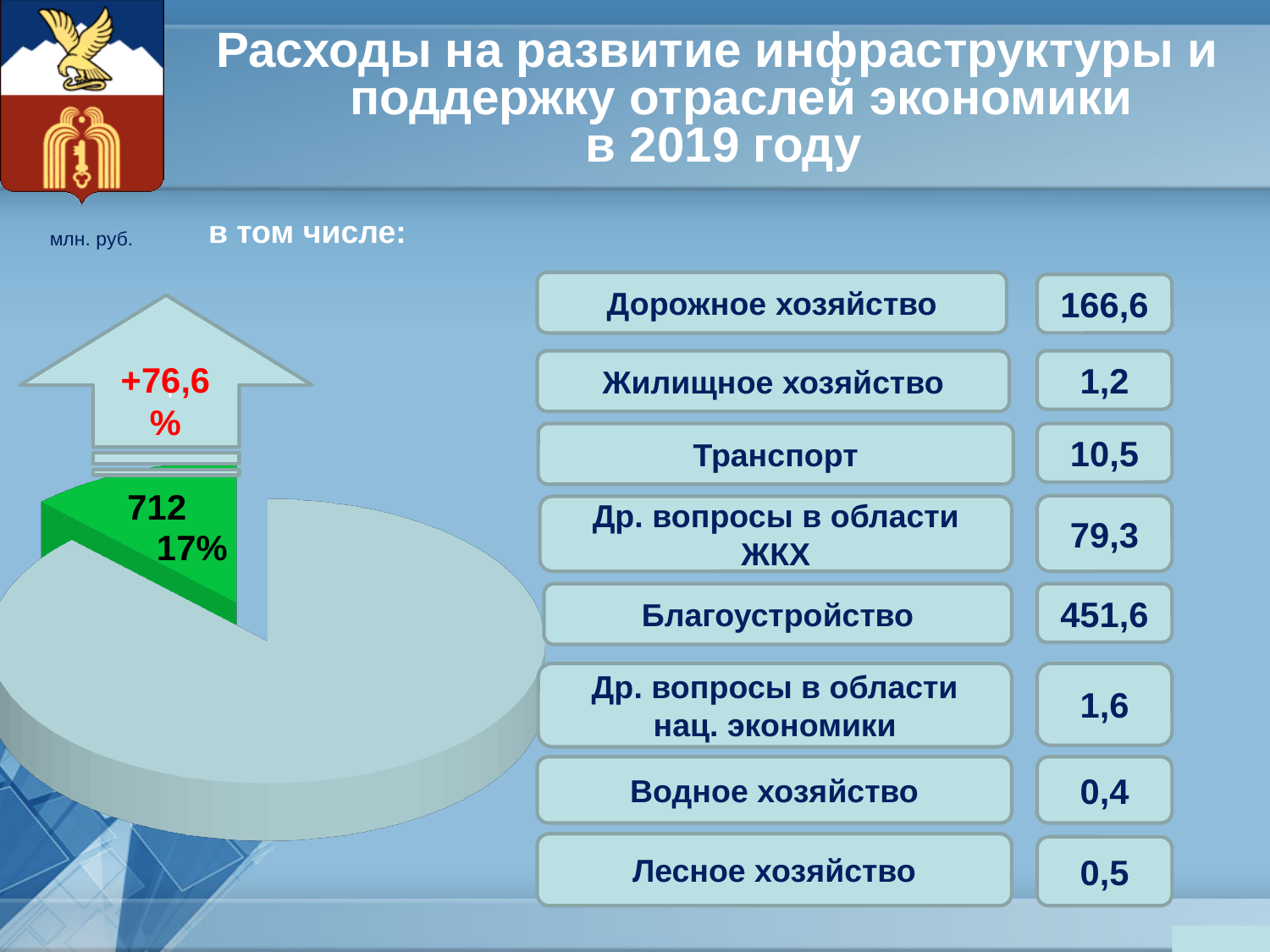
In the breakdown next to the pie chart, which item has the lowest value? Водное хозяйство In the breakdown next to the pie chart, what is the value for Благоустройство? 451,6 What unit is indicated for the values on the slide (top left)? млн. руб. How many slices does the pie chart have? 2 Which slice of the pie chart is larger, the green slice or the light blue slice? the light blue slice Is the share of the green slice greater or less than 50%? less What percentage change is printed in red on the arrow above the pie chart? +76,6 % In the breakdown next to the pie chart, what is the value for Дорожное хозяйство? 166,6 What value is printed on the green slice of the pie chart? 712 In the breakdown next to the pie chart, which item has the highest value? Благоустройство What share of the pie does the green slice represent? 17% What kind of chart is shown on the slide? pie chart